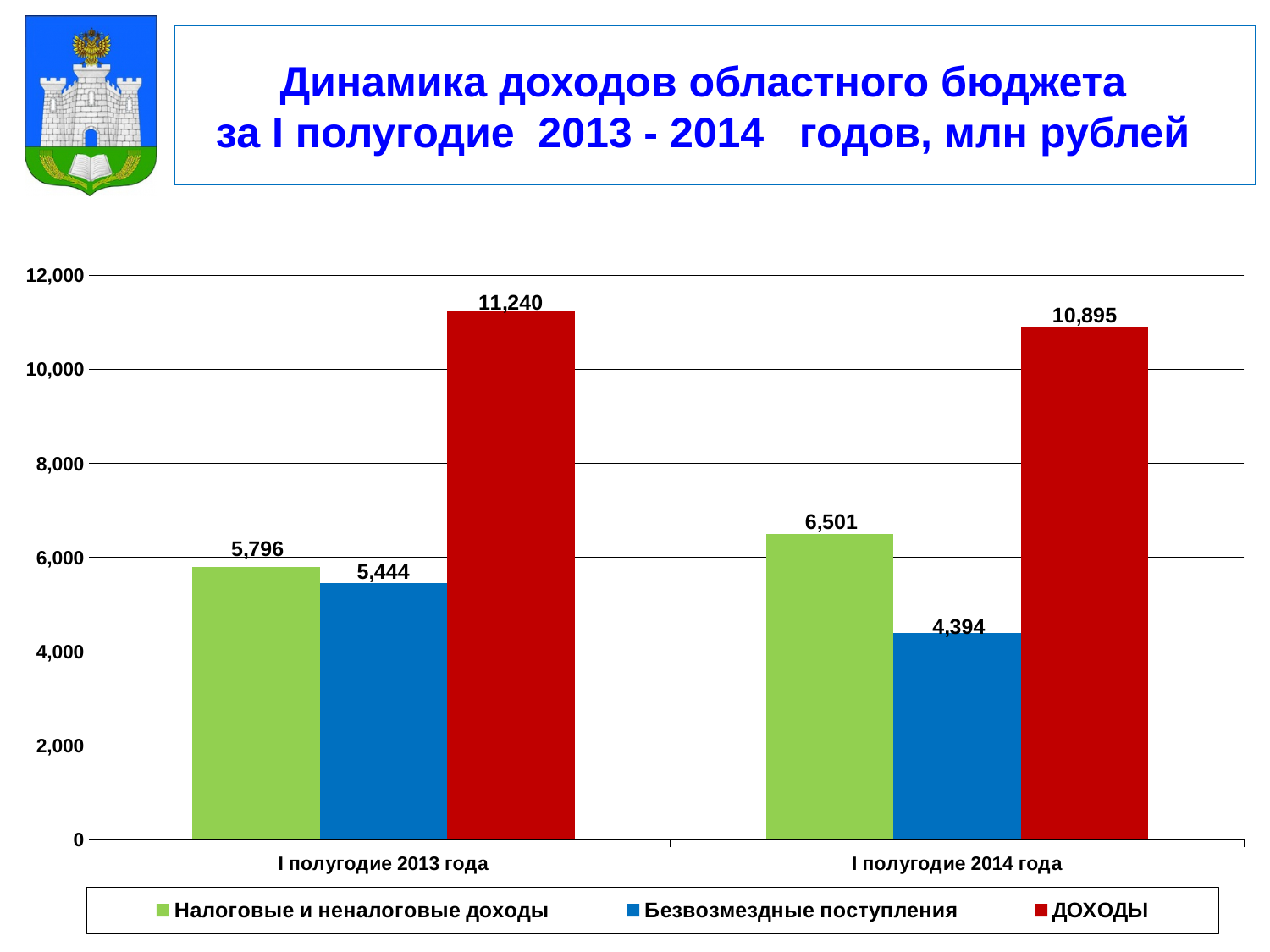
What is the difference between ДОХОДЫ for I полугодие 2013 года and I полугодие 2014 года? 345 What is the value of Налоговые и неналоговые доходы for I полугодие 2013 года? 5,796 What is the value of ДОХОДЫ for I полугодие 2013 года? 11,240 What is the value of Безвозмездные поступления for I полугодие 2014 года? 4,394 Which series has the highest value for I полугодие 2014 года? ДОХОДЫ What kind of chart is shown on the slide? Bar chart How many categories are shown on the x axis? 2 Which is larger: Безвозмездные поступления for I полугодие 2013 года or for I полугодие 2014 года? I полугодие 2013 года Which series has the lowest value for I полугодие 2014 года? Безвозмездные поступления What is the value of ДОХОДЫ for I полугодие 2014 года? 10,895 How many series does the legend list? 3 What is the difference between Налоговые и неналоговые доходы for I полугодие 2014 года and I полугодие 2013 года? 705